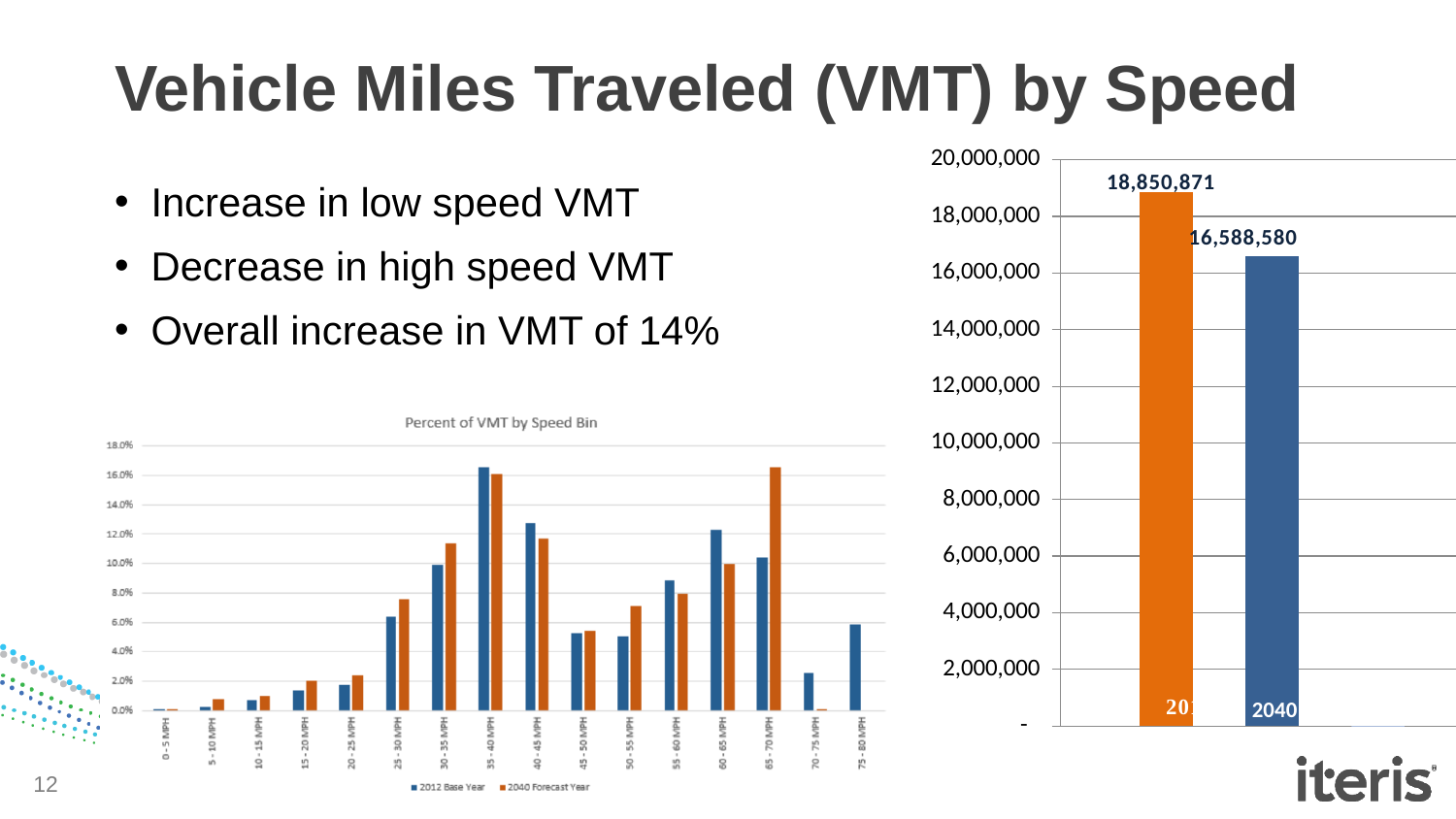
In the 'Percent of VMT by Speed Bin' chart, which speed bin has the highest value for the 2012 Base Year series? 35 - 40 MPH What are the two legend entries of the 'Percent of VMT by Speed Bin' chart? 2012 Base Year and 2040 Forecast Year What kind of chart is the 'Percent of VMT by Speed Bin' chart? Bar chart How many series does the legend of the 'Percent of VMT by Speed Bin' chart list? 2 In the chart on the right, what is the value of the taller (orange) bar? 18,850,871 How many speed bin categories are shown on the x axis of the 'Percent of VMT by Speed Bin' chart? 16 In the chart on the right, what is the difference between the two bar values? 2,262,291 In the 'Percent of VMT by Speed Bin' chart, is the 2040 Forecast Year value for 75 - 80 MPH greater or less than 2.0%? less In the 'Percent of VMT by Speed Bin' chart, for 60 - 65 MPH, which series has the larger value: 2012 Base Year or 2040 Forecast Year? 2012 Base Year In the chart on the right, how many bars are plotted? 2 In the 'Percent of VMT by Speed Bin' chart, is the 2040 Forecast Year value for 65 - 70 MPH greater or less than 14.0%? greater